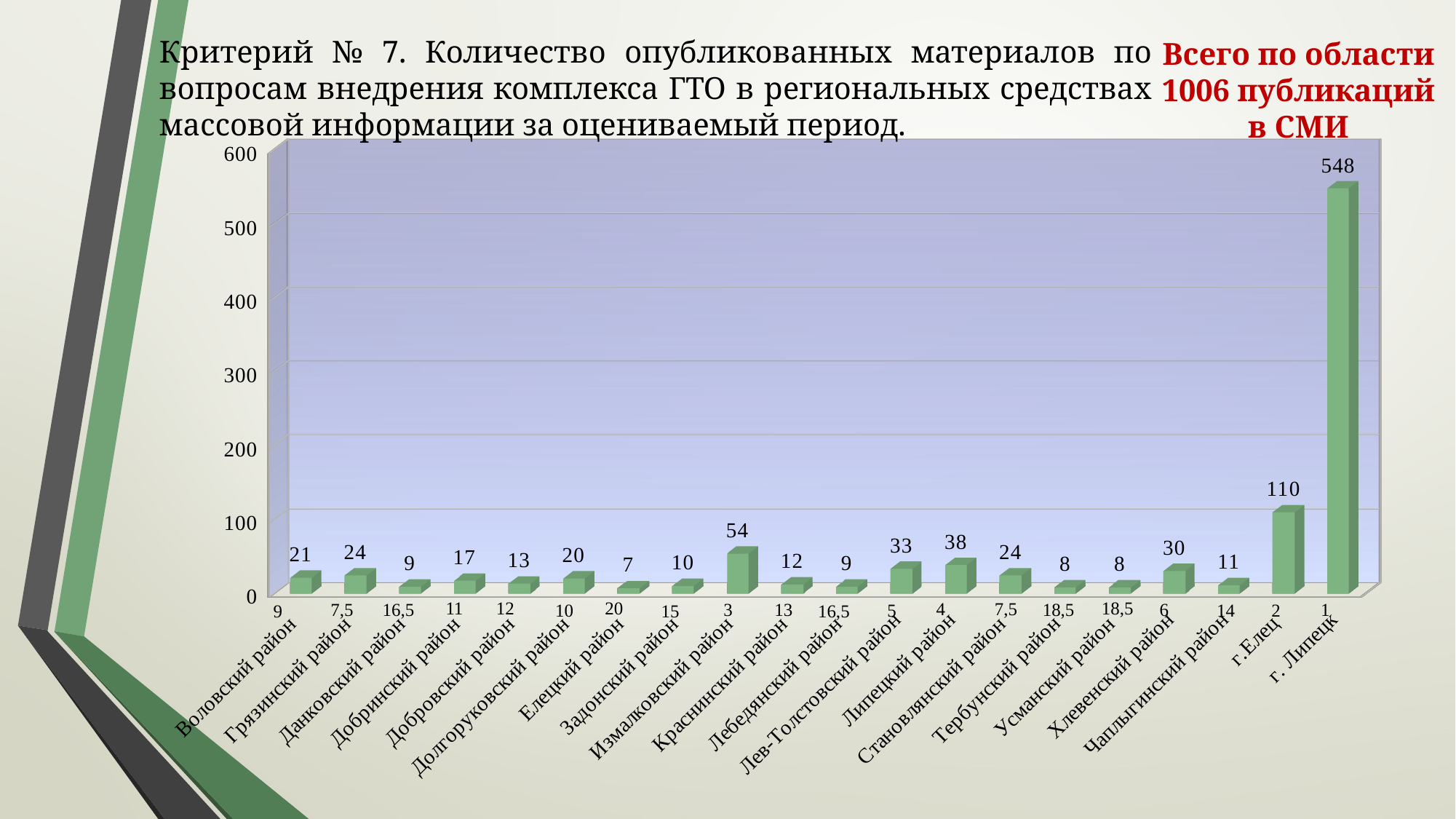
What is the difference between the values for Лев-Толстовский район and Липецкий район? 5 What is the value for г. Липецк? 548 Which category has the lowest value? Елецкий район Is the value for г. Липецк greater or less than 500? greater What is the value for Измалковский район? 54 What kind of chart is shown on the slide? bar chart What is the value for г.Елец? 110 Which category has the highest value? г. Липецк How many categories are shown on the x axis? 20 What is the value for Липецкий район? 38 Which is larger, the value for Хлевенский район or the value for Становлянский район? Хлевенский район What is the difference between the values for г. Липецк and г.Елец? 438